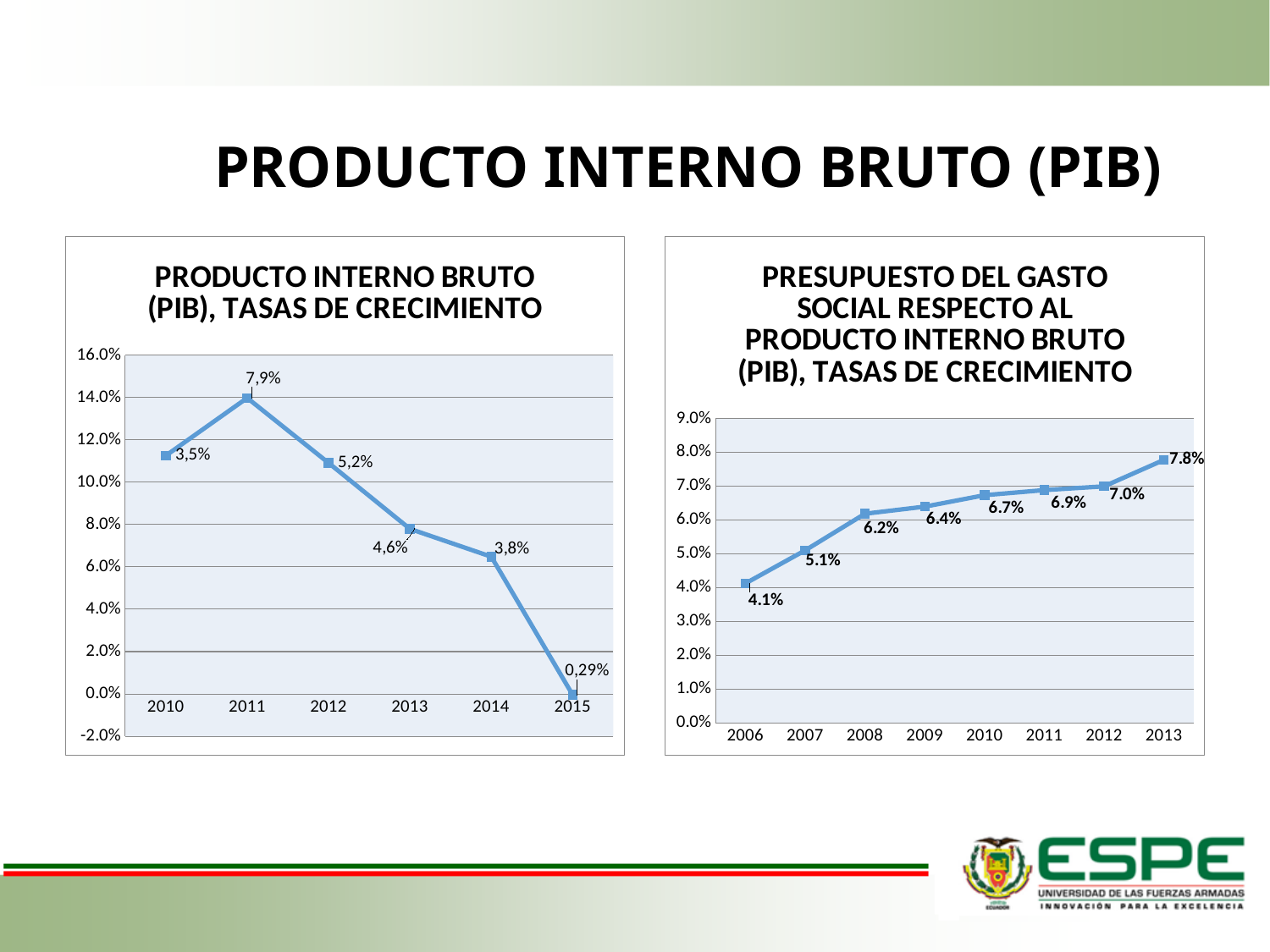
In the right chart (PRESUPUESTO DEL GASTO SOCIAL RESPECTO AL PIB), what is the value for 2006? 4.1% In the right chart (PRESUPUESTO DEL GASTO SOCIAL RESPECTO AL PIB), what is the value for 2013? 7.8% In the left chart (PRODUCTO INTERNO BRUTO (PIB), TASAS DE CRECIMIENTO), which year has the highest value? 2011 What kind of chart is the left chart (PRODUCTO INTERNO BRUTO (PIB), TASAS DE CRECIMIENTO)? Line chart In the right chart (PRESUPUESTO DEL GASTO SOCIAL RESPECTO AL PIB), which is larger, the value for 2008 or the value for 2012? 2012 In the left chart (PRODUCTO INTERNO BRUTO (PIB), TASAS DE CRECIMIENTO), what is the value labelled for 2015? 0,29% In the right chart (PRESUPUESTO DEL GASTO SOCIAL RESPECTO AL PIB), do the values rise or fall from 2006 to 2013? Rise In the left chart (PRODUCTO INTERNO BRUTO (PIB), TASAS DE CRECIMIENTO), what is the value labelled for 2011? 7,9% In the left chart (PRODUCTO INTERNO BRUTO (PIB), TASAS DE CRECIMIENTO), how many years are shown on the x axis? 6 In the right chart (PRESUPUESTO DEL GASTO SOCIAL RESPECTO AL PIB), what is the difference between the 2013 value and the 2006 value? 3.7% In the left chart (PRODUCTO INTERNO BRUTO (PIB), TASAS DE CRECIMIENTO), which year has the lowest value? 2015 In the right chart (PRESUPUESTO DEL GASTO SOCIAL RESPECTO AL PIB), how many years are plotted? 8